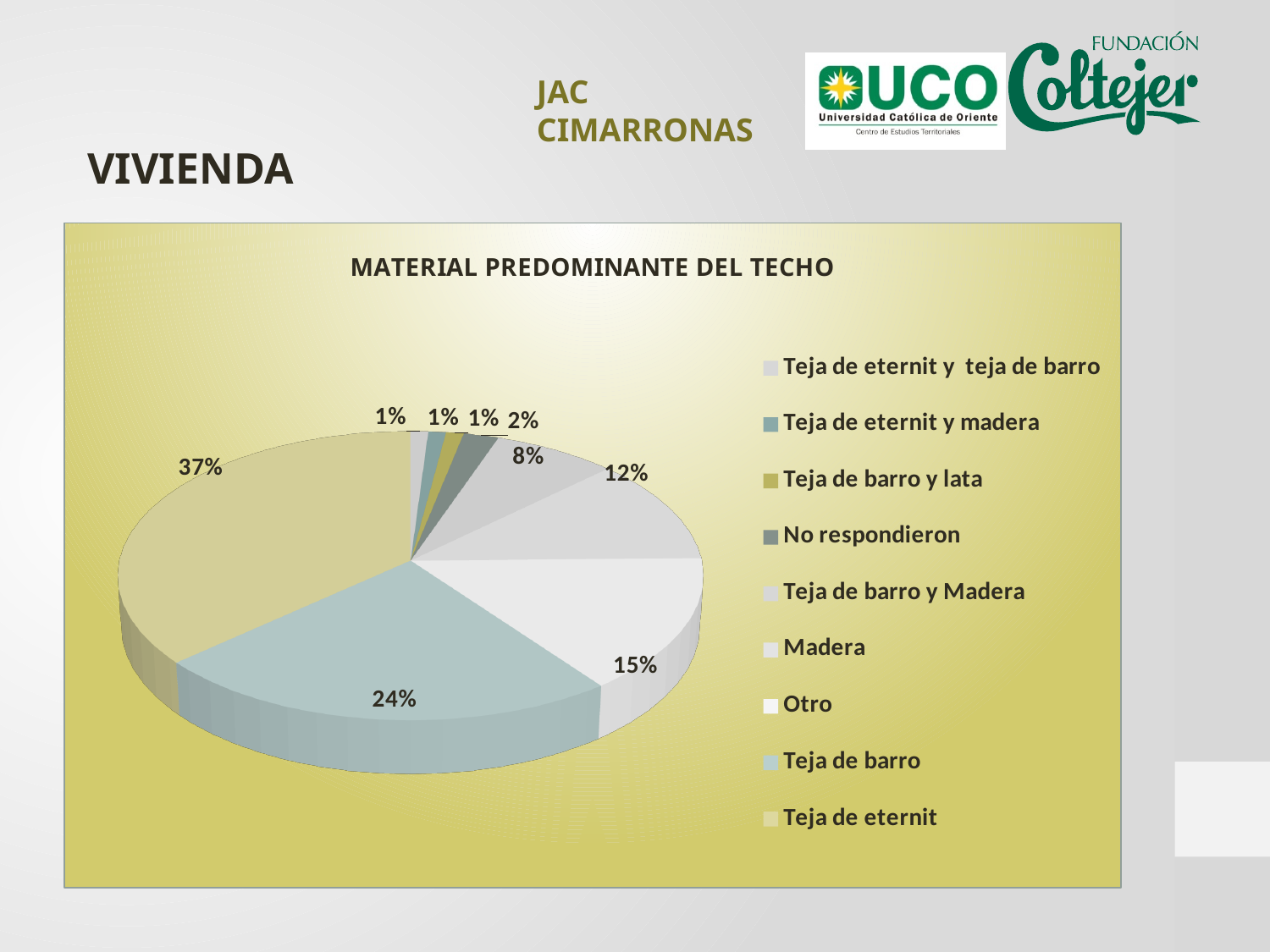
How many categories does the legend of the pie chart list? 9 What percentage is shown for Madera? 12% What percentage is shown for No respondieron? 2% Which category has the largest slice of the pie chart? Teja de eternit What share of the pie does Teja de eternit represent? 37% What share of the pie does Teja de barro represent? 24% What percentage is shown for Otro? 15% Which is larger, the slice for Teja de barro or the slice for Otro? Teja de barro What is the largest percentage shown on the pie chart? 37% What is the title of the chart? MATERIAL PREDOMINANTE DEL TECHO What is the difference in percentage points between the 37% slice and the 24% slice? 13 What kind of chart is shown on the slide? pie chart